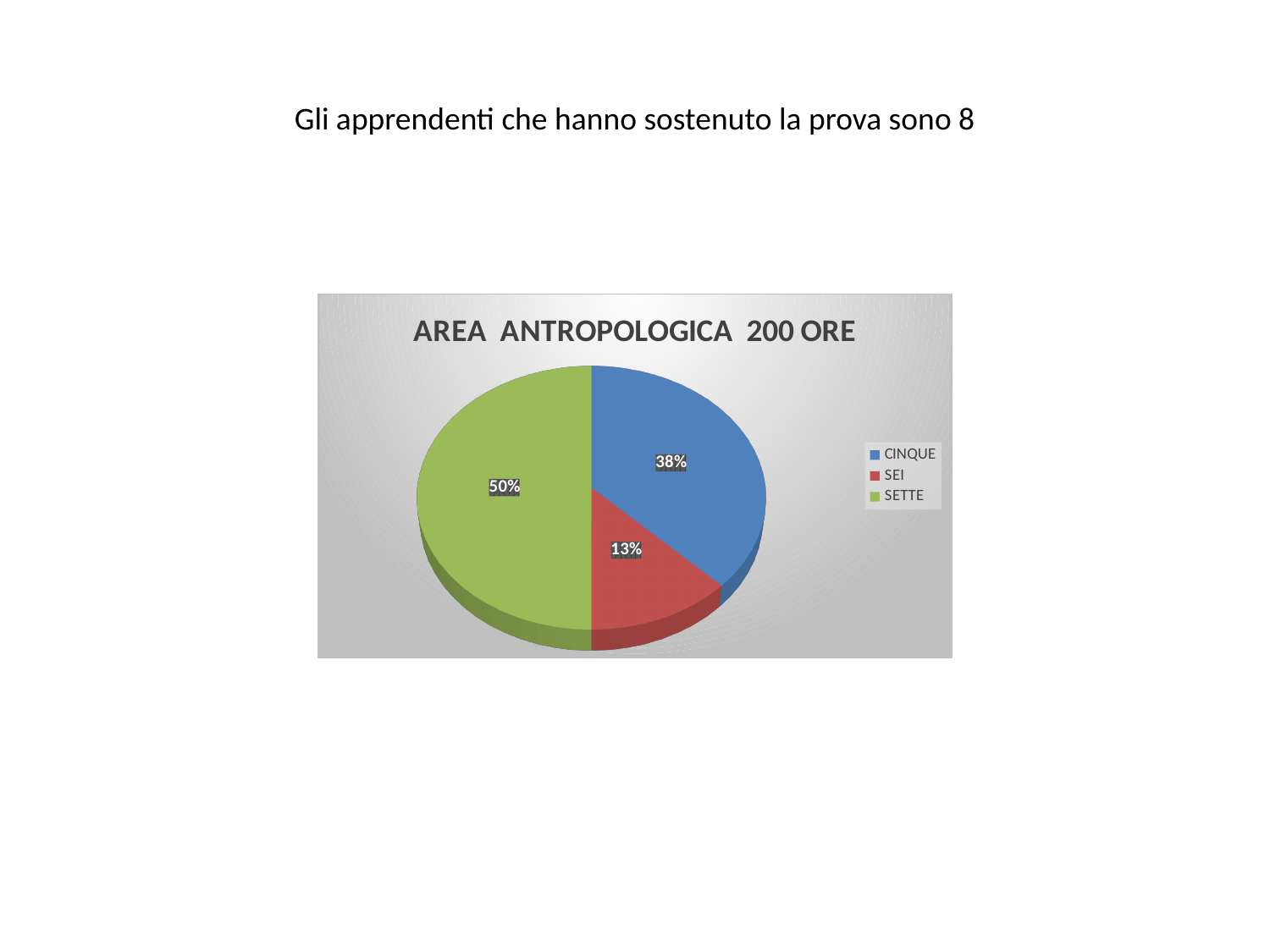
Which slice is larger, CINQUE or SEI? CINQUE What is the title of the chart? AREA ANTROPOLOGICA 200 ORE What share of the pie does the CINQUE slice represent? 38% What colour is the SEI slice in the pie chart? red Which category has the smallest slice of the pie? SEI What is the difference in percentage points between the SETTE slice and the CINQUE slice? 12% What kind of chart is shown on the slide? pie chart Which category has the largest slice of the pie? SETTE How many slices does the pie chart have? 3 What share of the pie does the SEI slice represent? 13% How many entries does the legend list? 3 What share of the pie does the SETTE slice represent? 50%